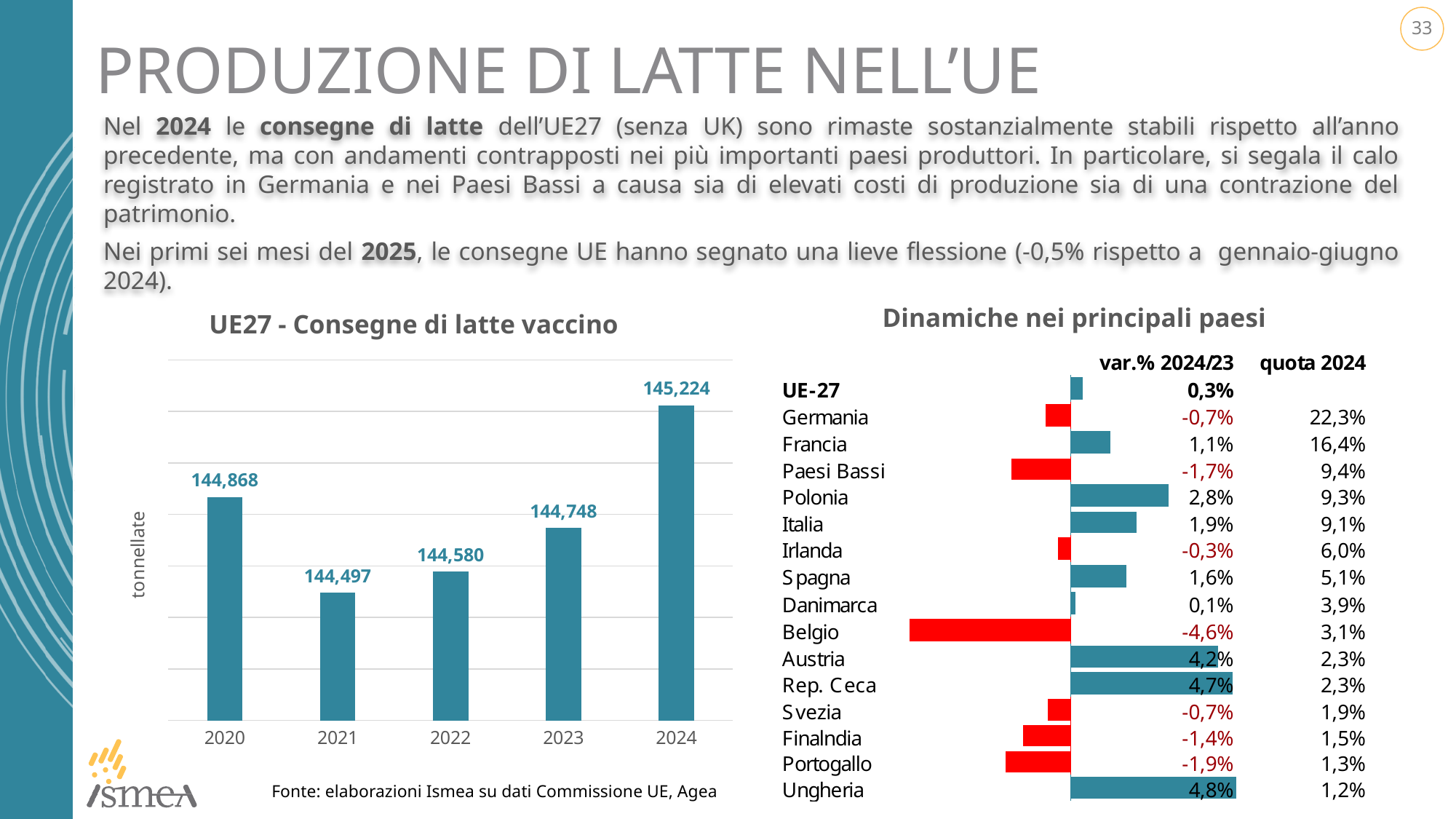
In the chart 'UE27 - Consegne di latte vaccino', what is the value for 2024? 145,224 What kind of chart is 'UE27 - Consegne di latte vaccino'? bar chart In the chart 'Dinamiche nei principali paesi', which country has the lowest var.% 2024/23? Belgio In the chart 'UE27 - Consegne di latte vaccino', which year has the highest value? 2024 In the chart 'Dinamiche nei principali paesi', what is the quota 2024 for Germania? 22,3% In the chart 'Dinamiche nei principali paesi', what is the var.% 2024/23 for Polonia? 2,8% In the chart 'UE27 - Consegne di latte vaccino', is the value for 2022 larger or smaller than the value for 2023? smaller In the chart 'Dinamiche nei principali paesi', which country has the highest var.% 2024/23? Ungheria In the chart 'UE27 - Consegne di latte vaccino', which year has the lowest value? 2021 In the chart 'Dinamiche nei principali paesi', what colour are the bars for countries with a negative var.% 2024/23? red In the chart 'UE27 - Consegne di latte vaccino', how many years are plotted? 5 In the chart 'UE27 - Consegne di latte vaccino', what is the difference between the 2024 value and the 2020 value? 356